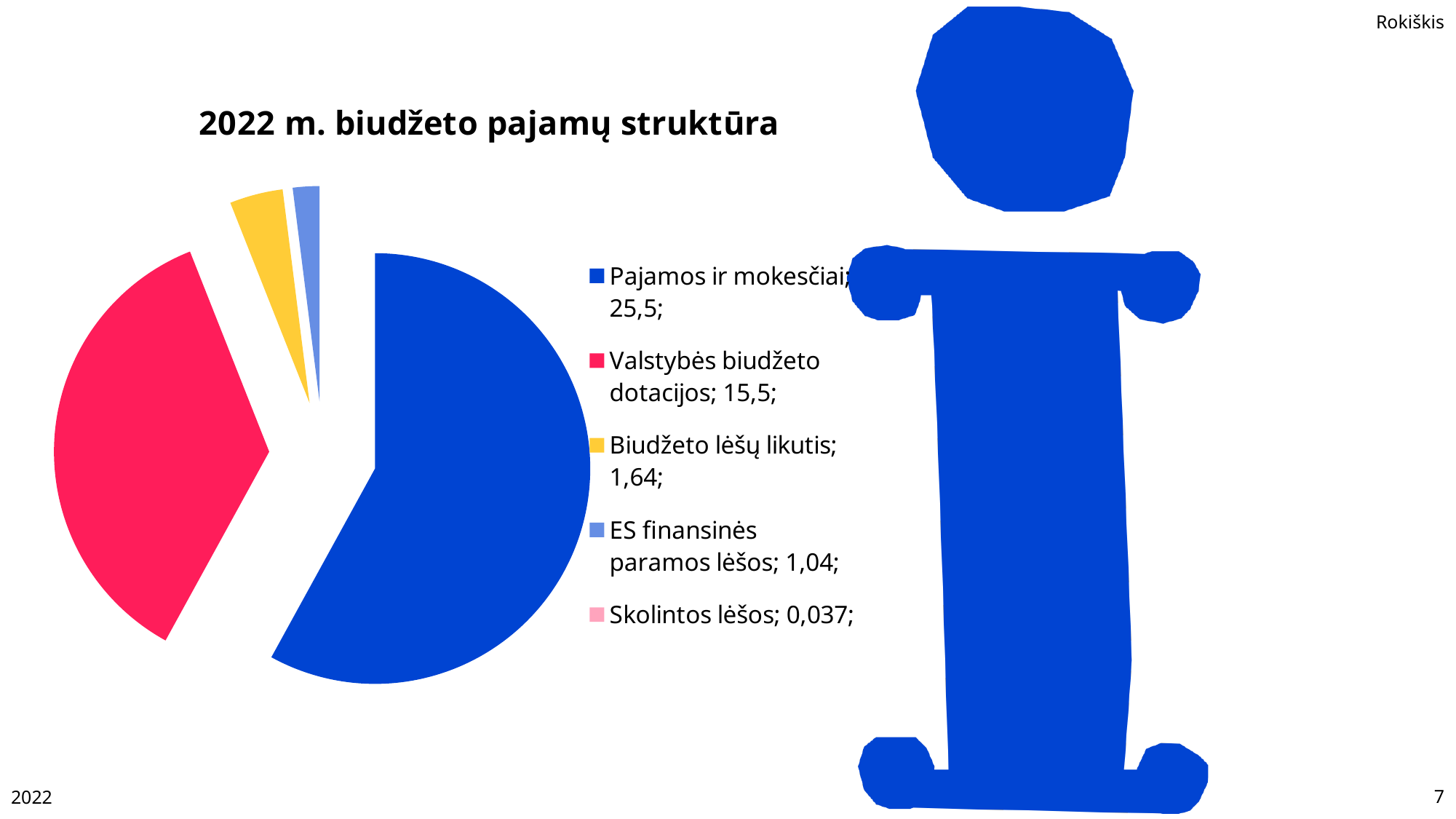
What type of chart is shown on the slide? pie chart Which is larger, Biudžeto lėšų likutis or ES finansinės paramos lėšos? Biudžeto lėšų likutis What is the value for Skolintos lėšos? 0,037 What is the value for ES finansinės paramos lėšos? 1,04 What is the title of the chart? 2022 m. biudžeto pajamų struktūra What is the value for Biudžeto lėšų likutis? 1,64 Which category has the smallest value? Skolintos lėšos What is the value for Pajamos ir mokesčiai? 25,5 Which category has the largest value? Pajamos ir mokesčiai How many categories does the legend list? 5 What is the difference between the values for Pajamos ir mokesčiai and Valstybės biudžeto dotacijos? 10 What is the value for Valstybės biudžeto dotacijos? 15,5